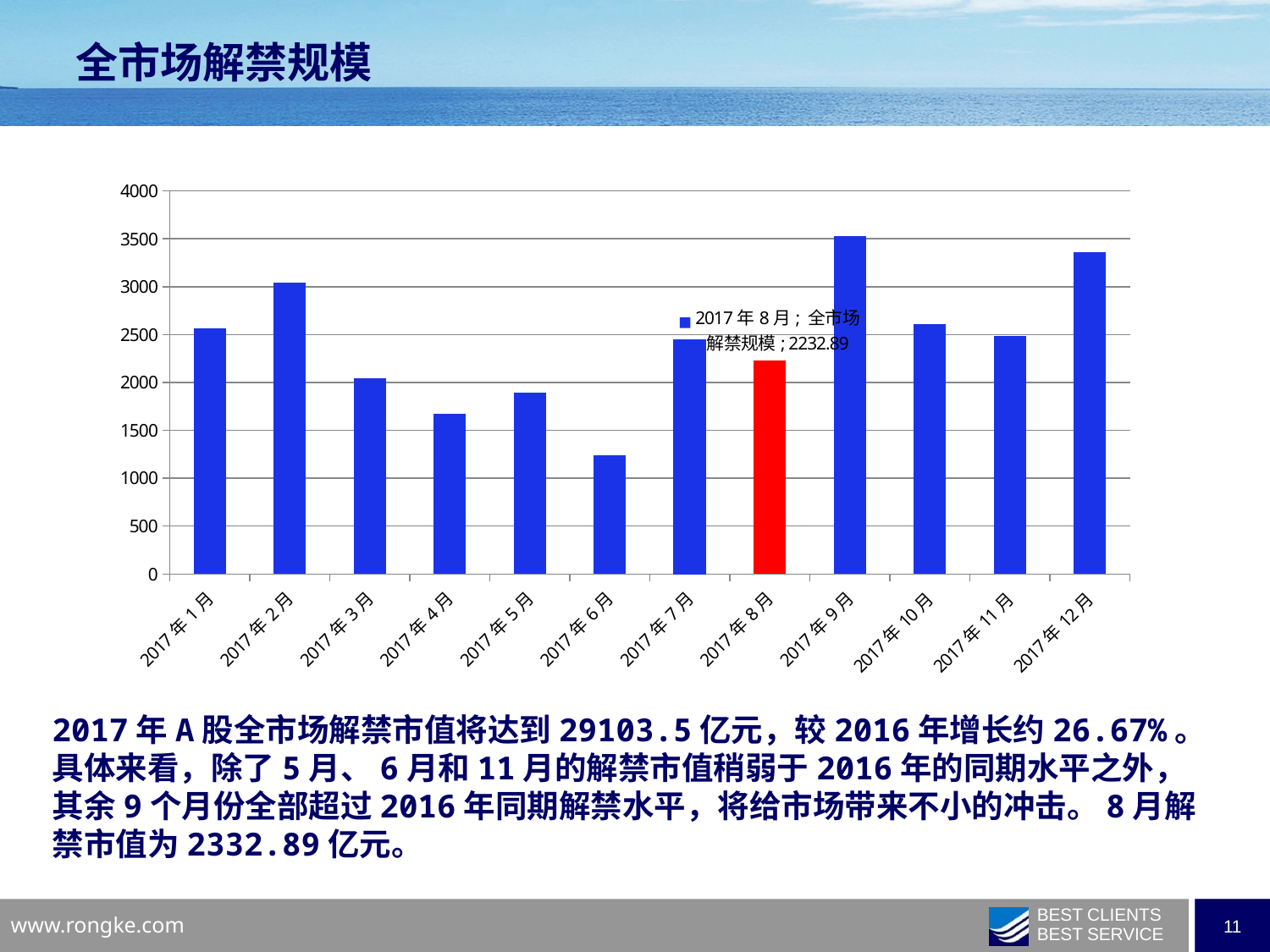
Is the value for 2017年12月 greater or less than 3000? greater Is the value for 2017年4月 greater or less than 2000? less Which month has the lowest bar on the chart? 2017年6月 Which month has the highest bar on the chart? 2017年9月 Which month's bar is highlighted in red? 2017年8月 Is the value for 2017年6月 greater or less than 1500? less Do the values rise or fall from 2017年2月 to 2017年6月? fall How many months (categories) are plotted on the chart? 12 Which is larger, the value for 2017年7月 or 2017年8月? 2017年7月 What kind of chart is shown on the slide? bar chart What is the value shown for 2017年8月? 2232.89